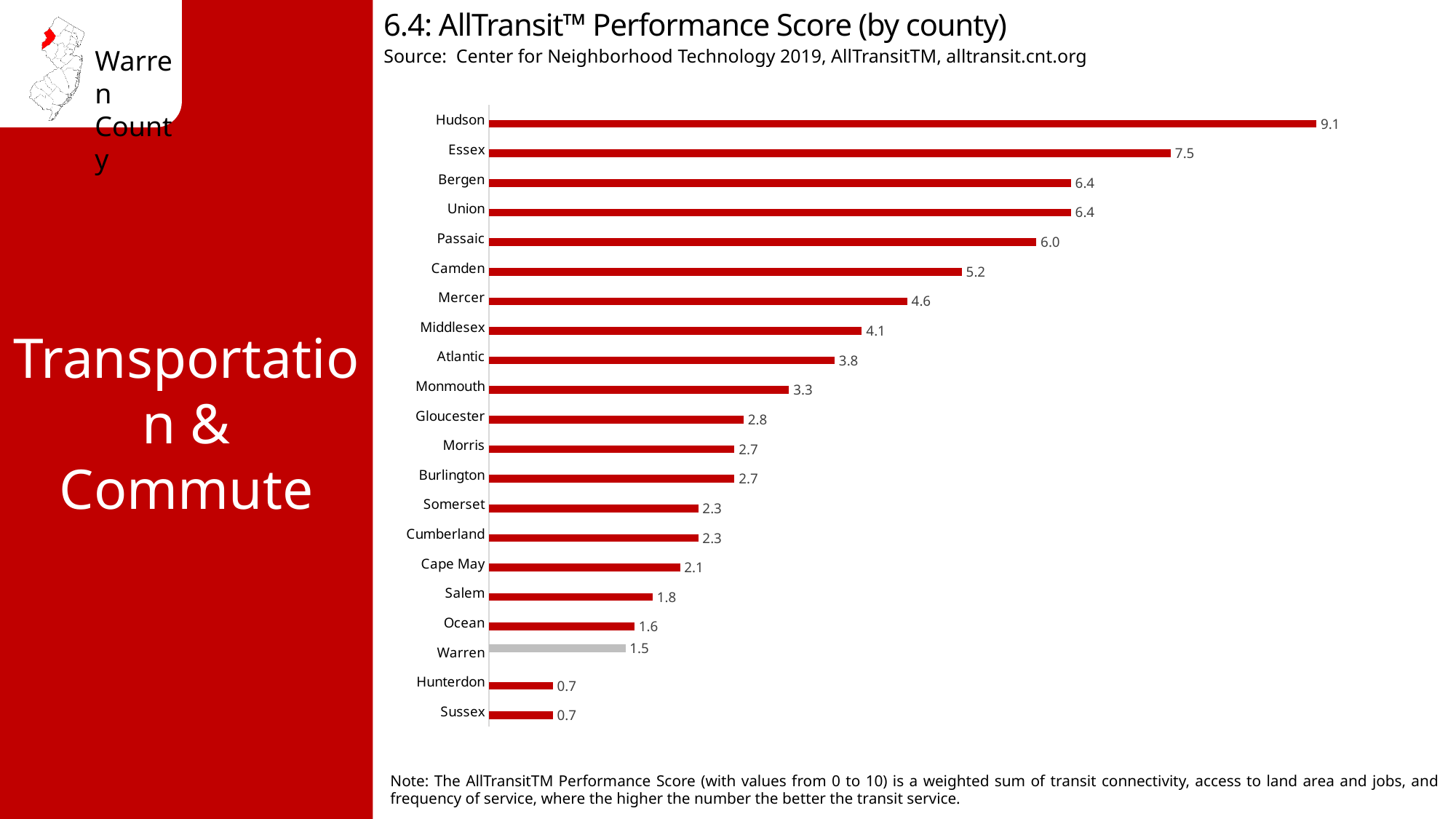
Which county has the highest AllTransit Performance Score? Hudson Which county's bar is shown in a different colour (grey) from the others? Warren How many counties are shown in the chart? 21 What is the AllTransit Performance Score for Warren county? 1.5 What is the difference between the AllTransit Performance Scores of Warren and Ocean? 0.1 Which has a higher AllTransit Performance Score, Camden or Middlesex? Camden What is the AllTransit Performance Score for Mercer county? 4.6 What is the difference between the AllTransit Performance Scores of Hudson and Essex? 1.6 Which has a higher AllTransit Performance Score, Salem or Cape May? Cape May What is the AllTransit Performance Score for Hudson county? 9.1 What kind of chart is used to show the AllTransit Performance Score by county? Bar chart What is the source cited for the AllTransit Performance Score chart? Center for Neighborhood Technology 2019, AllTransitTM, alltransit.cnt.org